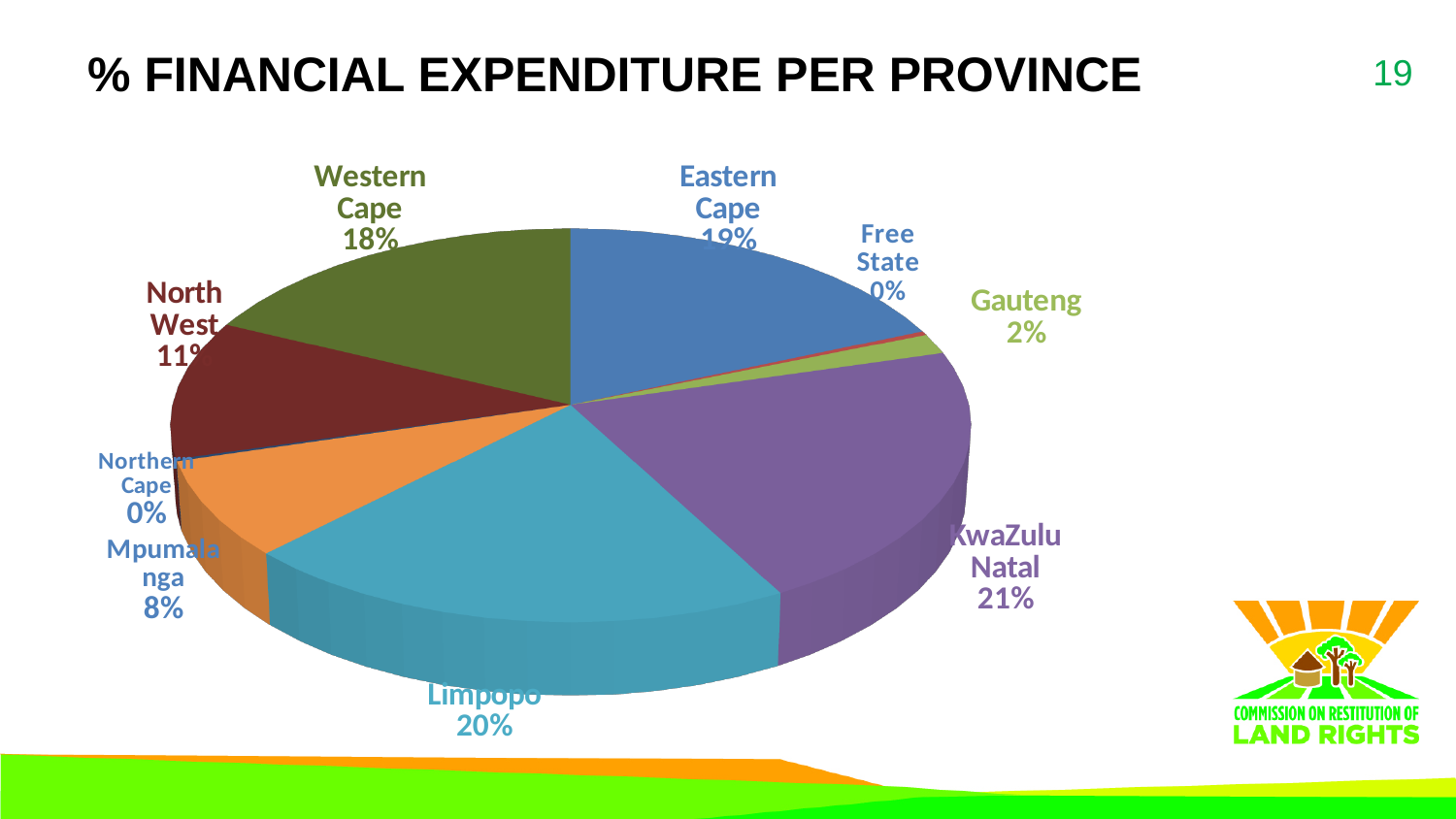
How many provinces are shown in the pie chart? 9 What is the difference in percentage points between Western Cape and Mpumalanga? 10 What percentage of financial expenditure is shown for Western Cape? 18% Which province has the largest share of financial expenditure? KwaZulu Natal Which has the larger share of expenditure, Limpopo or Eastern Cape? Limpopo What is the difference in percentage points between Eastern Cape and North West? 8 What percentage of financial expenditure is shown for Mpumalanga? 8% What percentage of financial expenditure is shown for KwaZulu Natal? 21% What kind of chart is shown on the slide? Pie chart What is the title of the chart? % FINANCIAL EXPENDITURE PER PROVINCE Which two provinces are labelled with 0% expenditure? Free State and Northern Cape What percentage of financial expenditure is shown for Gauteng? 2%